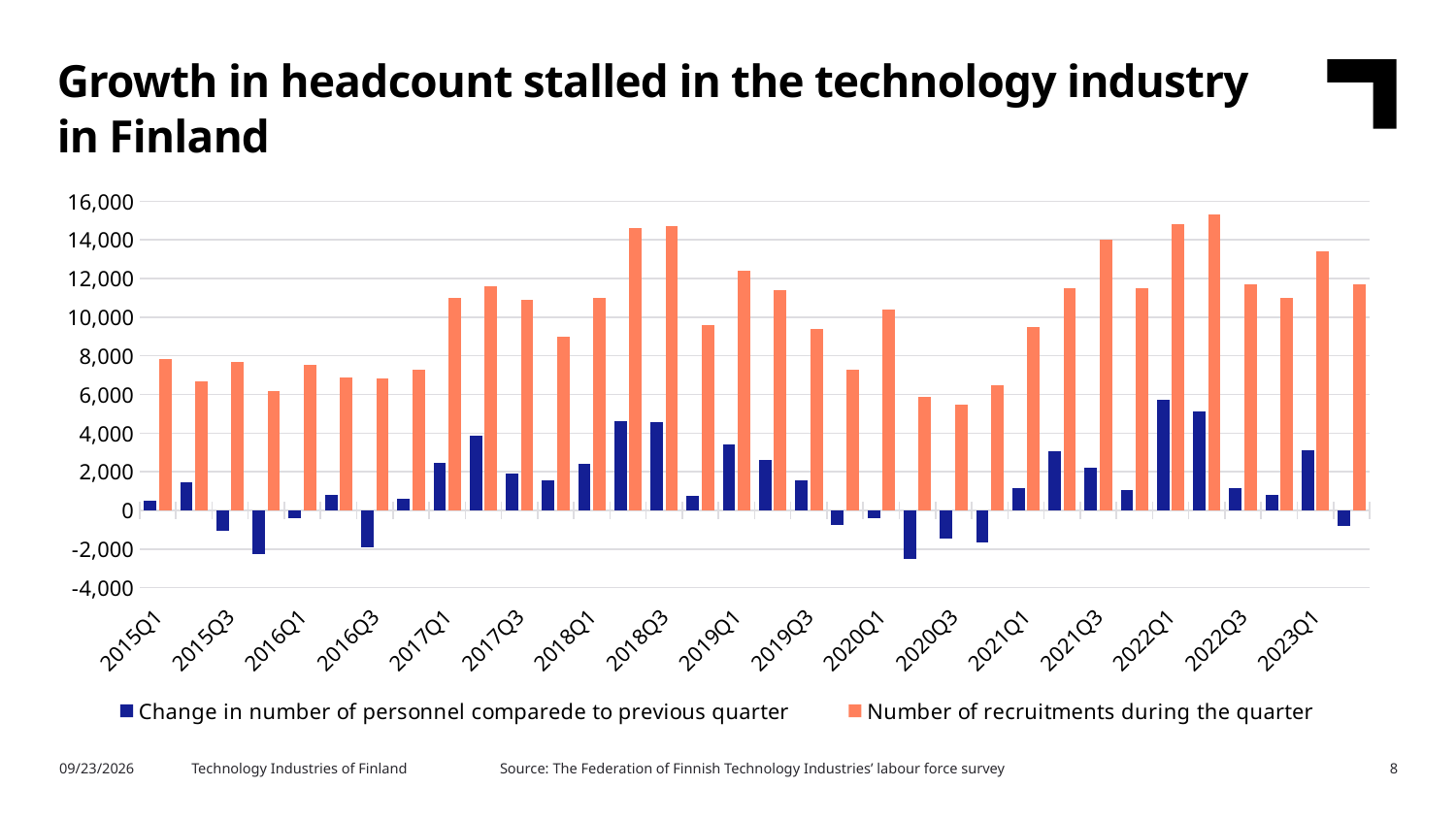
Is the number of recruitments during the quarter in 2020Q3 greater or less than 8,000? less What is the title of the slide? Growth in headcount stalled in the technology industry in Finland What kind of chart is shown on the slide? Bar chart How many series does the legend list? 2 Which colour represents the series 'Number of recruitments during the quarter'? Orange Which quarter has more recruitments during the quarter, 2017Q1 or 2016Q3? 2017Q1 In which quarter is the number of recruitments during the quarter highest? 2022Q2 Is the change in number of personnel compared to previous quarter in 2022Q1 greater or less than 4,000? greater In which quarter is the change in number of personnel compared to previous quarter highest? 2022Q1 Is the change in number of personnel compared to previous quarter in 2020Q2 greater or less than -2,000? less Do the number of recruitments during the quarter generally rise or fall from 2020Q3 to 2022Q3? Rise